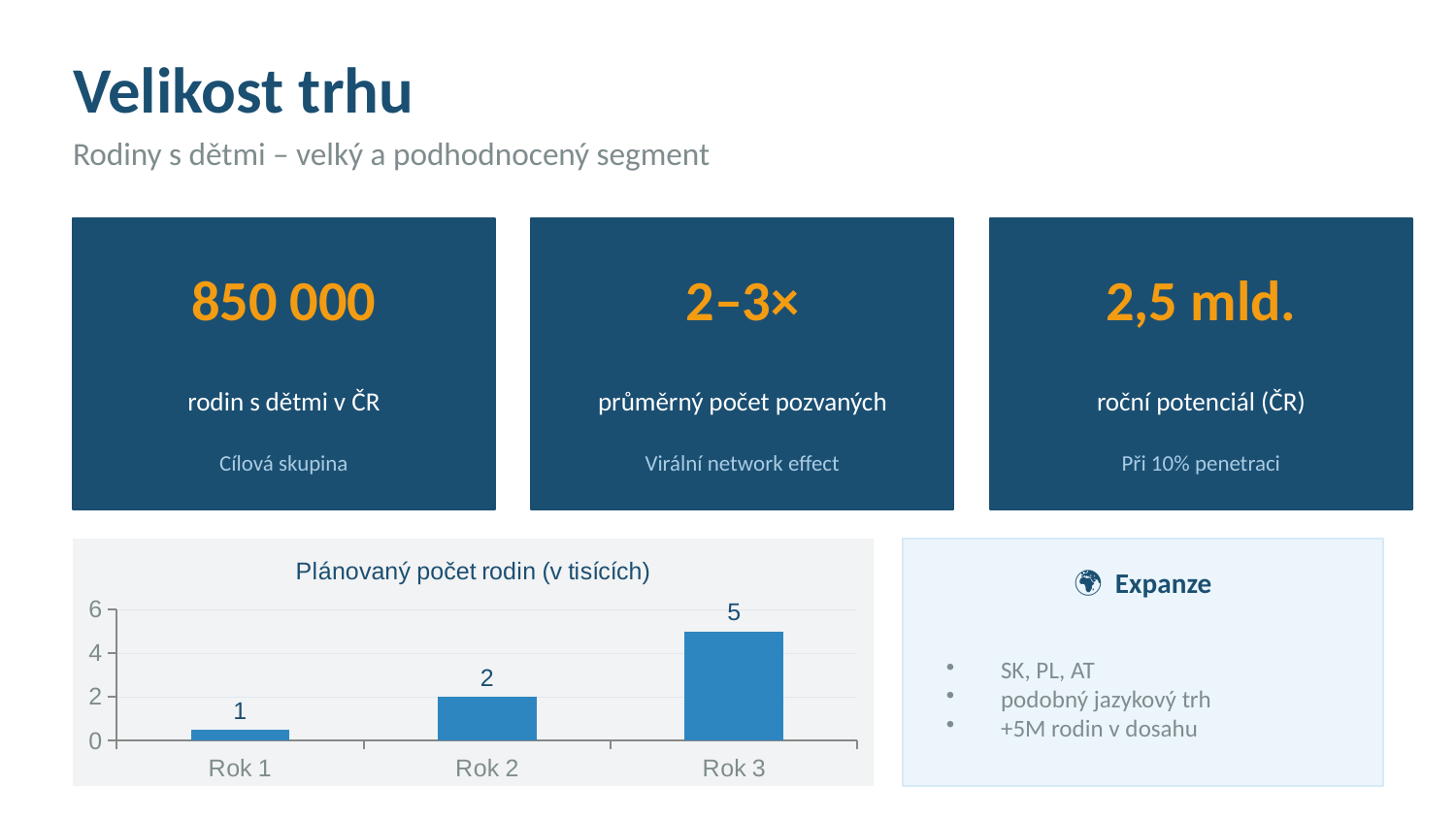
Which category has the highest value in the chart? Rok 3 What is the title of the chart on the slide? Plánovaný počet rodin (v tisících) Which is larger, the value for Rok 2 or the value for Rok 3? Rok 3 What is the value for Rok 3 in the chart? 5 What is the value for Rok 2 in the chart? 2 Which category has the lowest value in the chart? Rok 1 What is the difference between the values for Rok 3 and Rok 2? 3 Is the value for Rok 3 greater or less than 4? greater What type of chart is shown on the slide? bar chart What is the value for Rok 1 in the chart? 1 Do the values rise or fall from Rok 1 to Rok 3? rise How many categories are shown on the x axis of the chart? 3